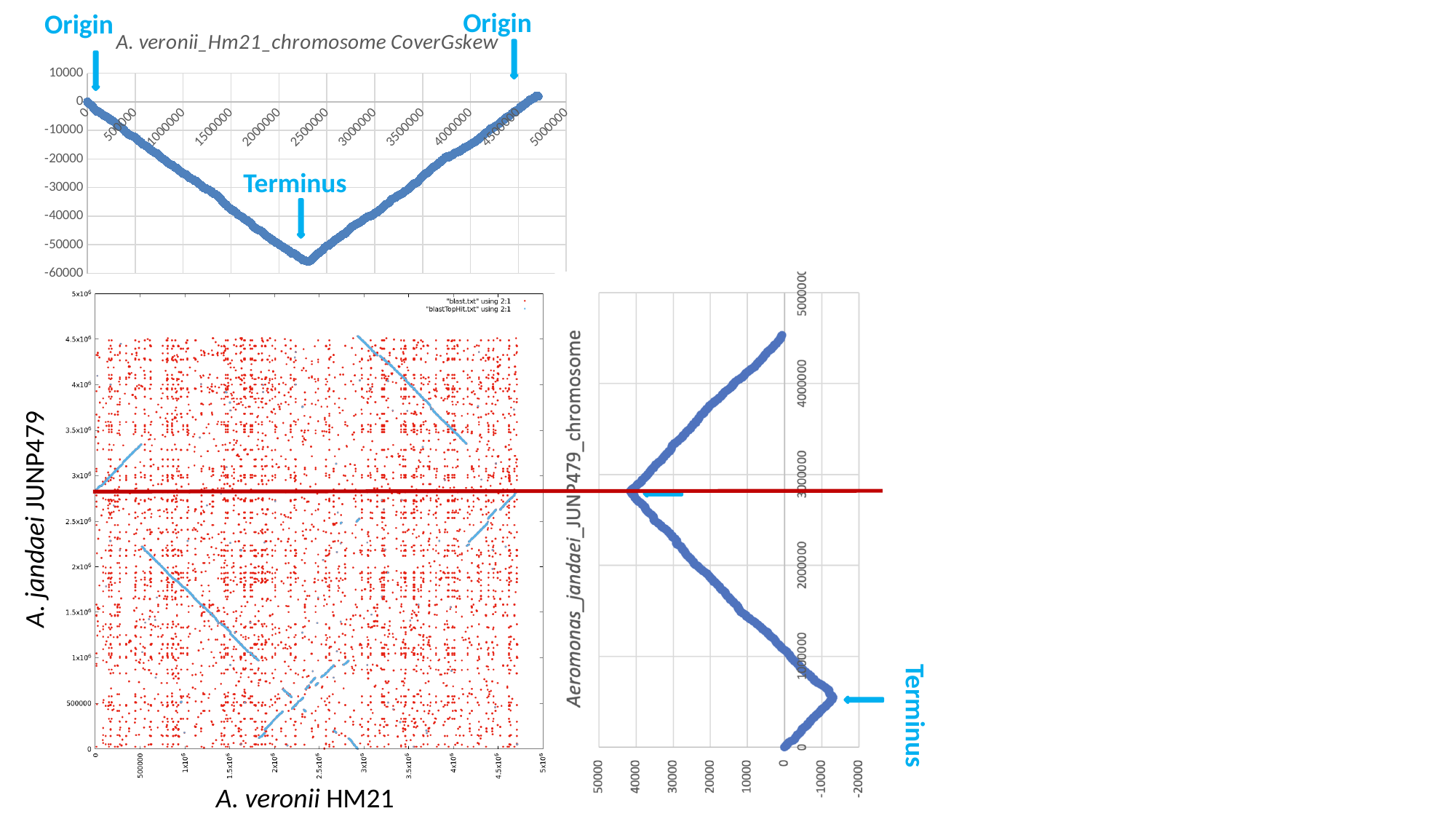
In the top chart, which labelled feature is marked at the lowest point of the curve? Terminus In the top chart (A. veronii_Hm21_chromosome CoverGskew), is the lowest plotted value greater or less than -50000? less In the top chart (A. veronii_Hm21_chromosome CoverGskew), do the values rise or fall as x goes from 3000000 to 4500000? rise In the bottom-right chart (Aeromonas_jandaei_JUNP479_chromosome), is the value at chromosome position 2000000 greater or less than 10000? greater What is the title of the chart at the top of the slide? A. veronii_Hm21_chromosome CoverGskew In the top chart (A. veronii_Hm21_chromosome CoverGskew), is the value at x = 4000000 greater or less than -10000? less In the top chart (A. veronii_Hm21_chromosome CoverGskew), do the values rise or fall as x goes from 0 to 2000000? fall How many series does the legend of the bottom-left dot plot (A. jandaei JUNP479 vs A. veronii HM21) list? 2 What kind of chart is the bottom-left plot of A. jandaei JUNP479 against A. veronii HM21? scatter plot